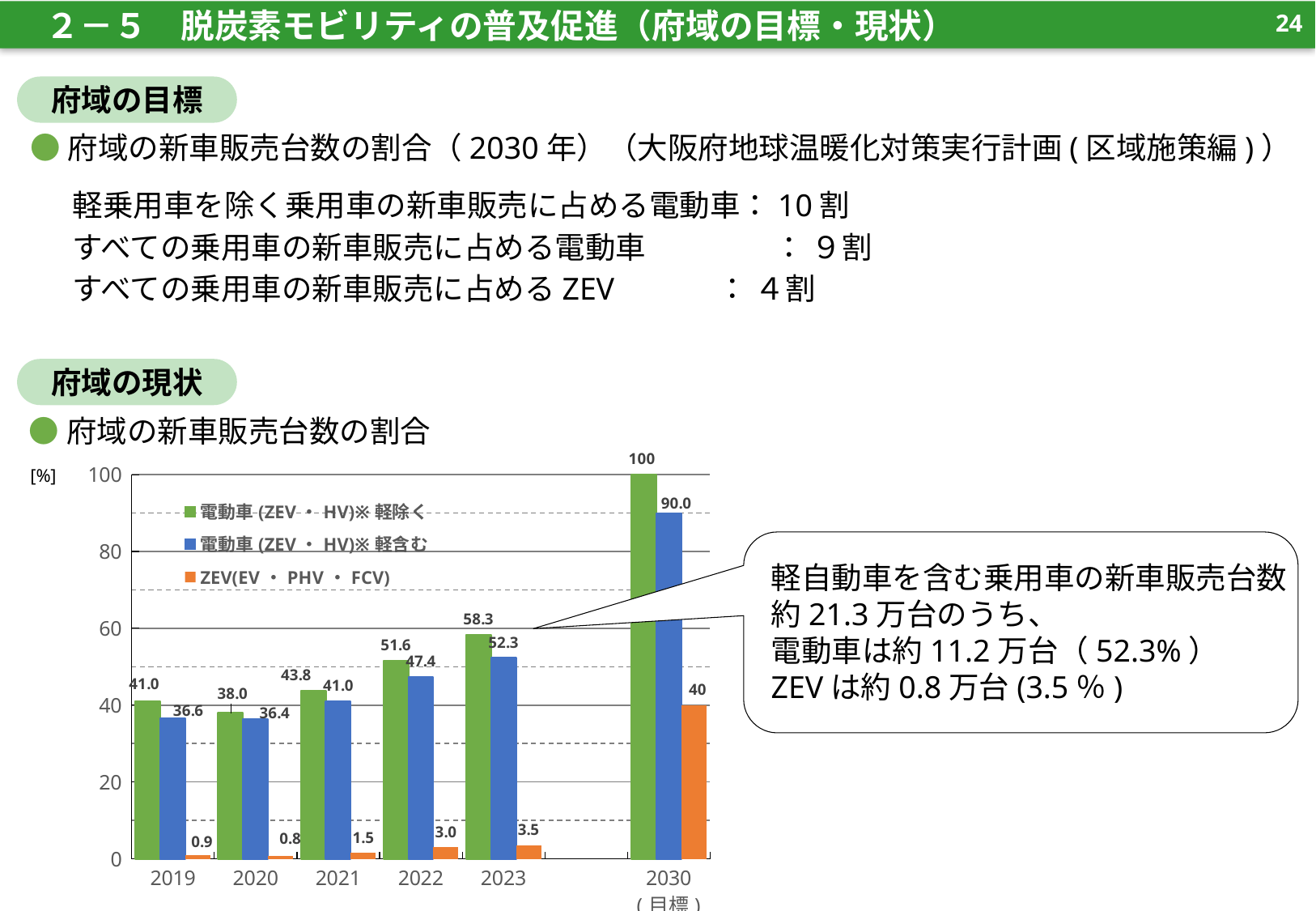
What is the value for ZEV(EV・PHV・FCV) in 2022? 3.0 Is the value for 電動車(ZEV・HV)※軽含む in 2023 greater or less than 40? greater Which is larger: the ZEV(EV・PHV・FCV) value in 2021 or in 2023? 2023 How many series does the chart's legend list? 3 Among the years 2019 to 2023, which year has the lowest value for 電動車(ZEV・HV)※軽除く? 2020 What is the value for 電動車(ZEV・HV)※軽除く in 2023? 58.3 What is the value for 電動車(ZEV・HV)※軽含む in 2020? 36.4 What kind of chart is shown on the slide? bar chart Which category has the highest value for ZEV(EV・PHV・FCV)? 2030(目標) How many categories are shown on the x axis of the chart? 6 What is the value for 電動車(ZEV・HV)※軽含む in 2030(目標)? 90.0 What is the difference between the 電動車(ZEV・HV)※軽除く value and the 電動車(ZEV・HV)※軽含む value in 2022? 4.2